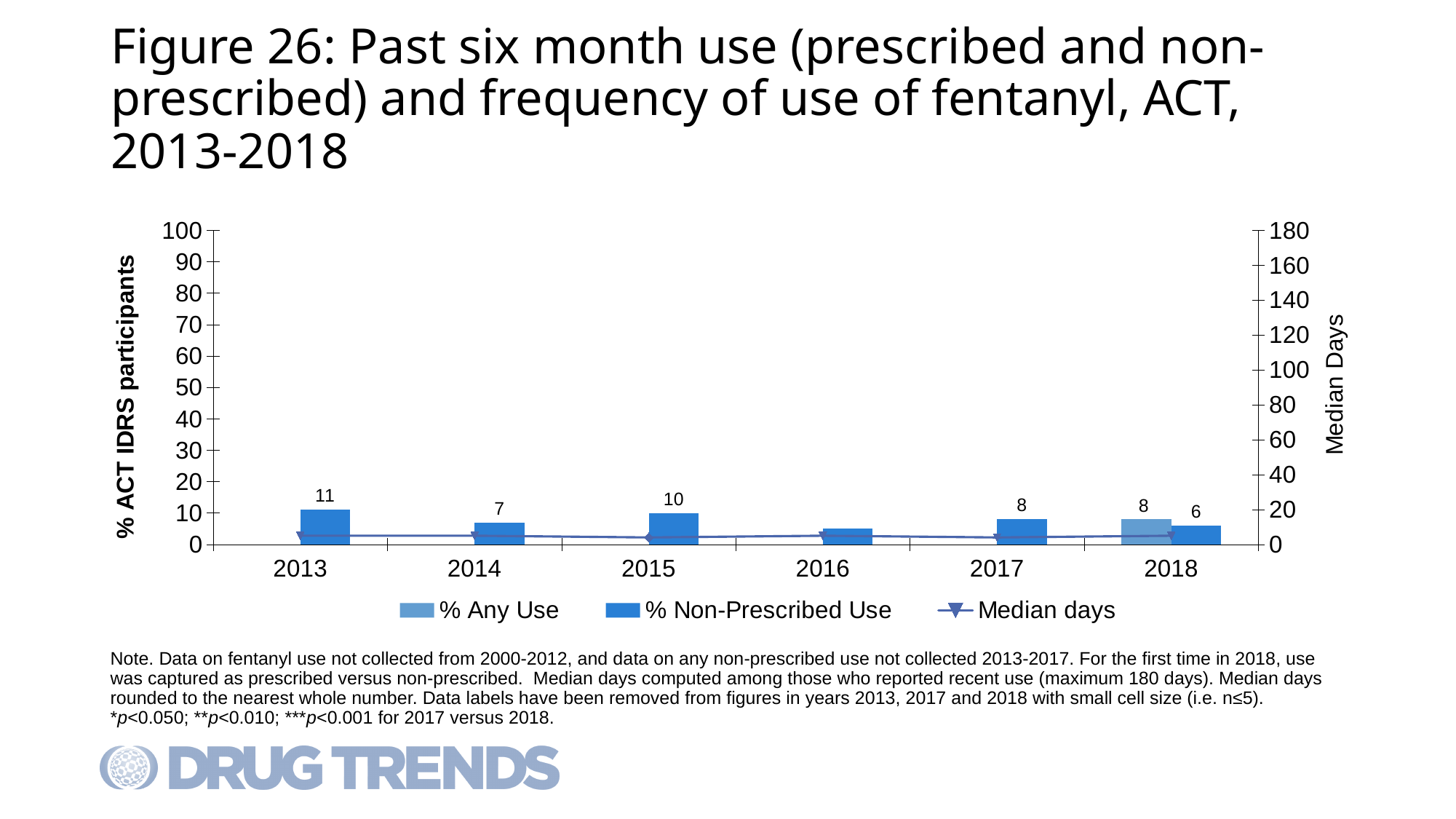
What is the difference between the bar values for 2013 and 2014? 4 What is the value of the bar for 2017? 8 What is the value of the bar for 2014? 7 Which year has the larger bar value, 2015 or 2017? 2015 Is the Median days value for 2016 greater or less than 20? less What is the % Any Use value for 2018? 8 What is the value of the bar for 2015? 10 How many series does the legend list? 3 What is the % Non-Prescribed Use value for 2018? 6 In 2018, what is the difference between % Any Use and % Non-Prescribed Use? 2 Which year has the highest bar? 2013 What is the value of the bar for 2013? 11